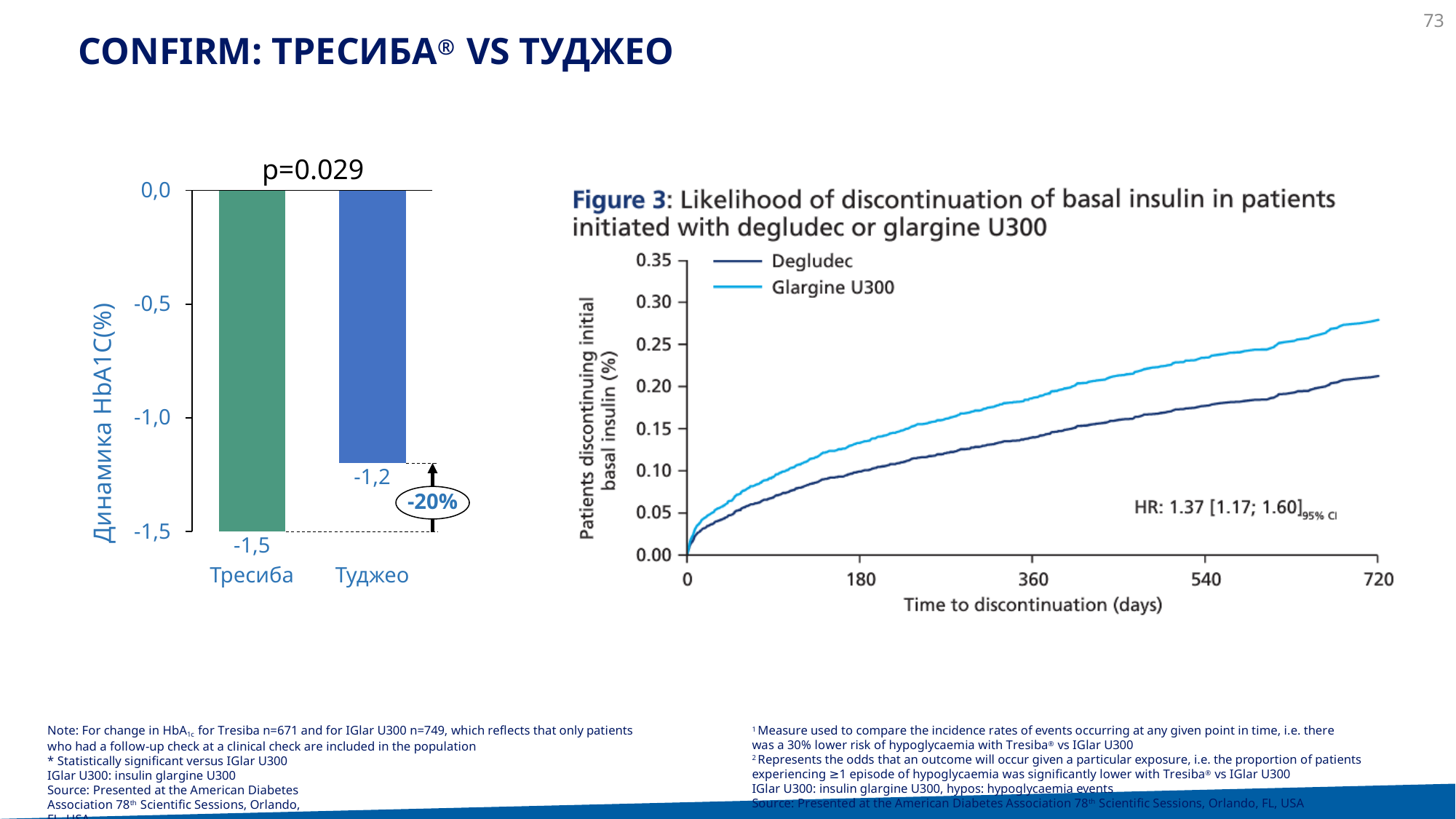
On the left bar chart, what p-value is printed above the bars? p=0.029 On the left bar chart, what is the difference between the values for Тресиба and Туджео? 0,3 On the left bar chart, what is the value for Тресиба? -1,5 What kind of chart is the chart on the left of the slide? bar chart On the Figure 3 chart, do the values for Glargine U300 rise or fall as time to discontinuation increases? rise On the left bar chart, what is the value for Туджео? -1,2 On the Figure 3 chart, what kind of chart is shown? line chart On the Figure 3 chart, how many series does the legend list? 2 On the left bar chart, which category shows the larger reduction in HbA1c? Тресиба On the left bar chart, how many categories are shown? 2 On the Figure 3 chart, is the value for Degludec at 720 days greater or less than 0.25? less On the Figure 3 chart, is the value for Glargine U300 at 720 days greater or less than 0.25? greater